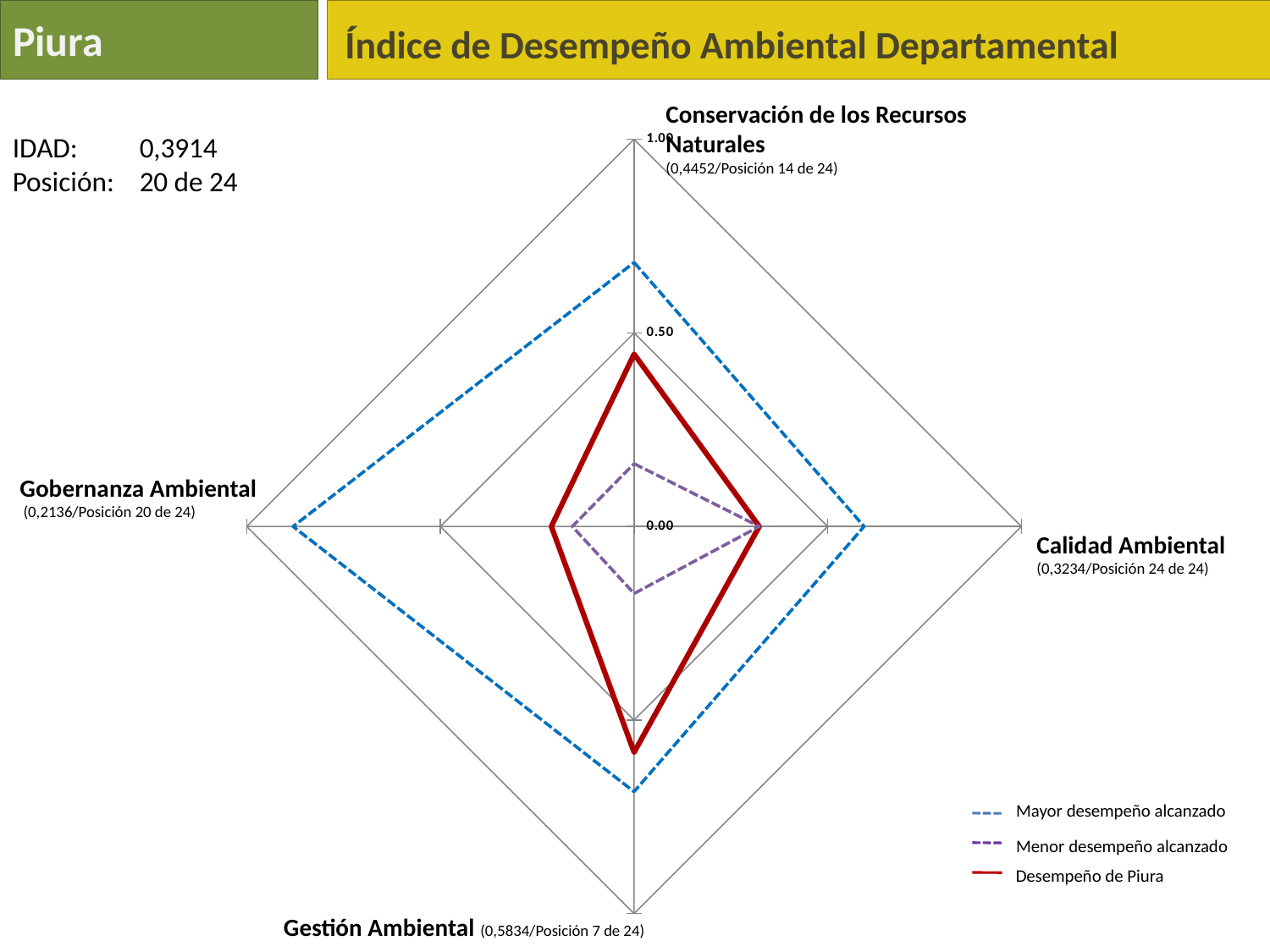
How many axes (categories) does the radar chart have? 4 What is Piura's value for Gestión Ambiental? 0,5834 How many series does the legend list? 3 What is Piura's value for Calidad Ambiental? 0,3234 Which is larger for Piura: Conservación de los Recursos Naturales or Calidad Ambiental? Conservación de los Recursos Naturales What type of chart is shown on the slide? radar chart Is Piura's value for Gestión Ambiental greater or less than 0.50? greater Which series is drawn as a solid red line? Desempeño de Piura What is Piura's value for Conservación de los Recursos Naturales? 0,4452 In which category does Piura have its lowest value? Gobernanza Ambiental What is Piura's value for Gobernanza Ambiental? 0,2136 In which category does Piura have its highest value? Gestión Ambiental